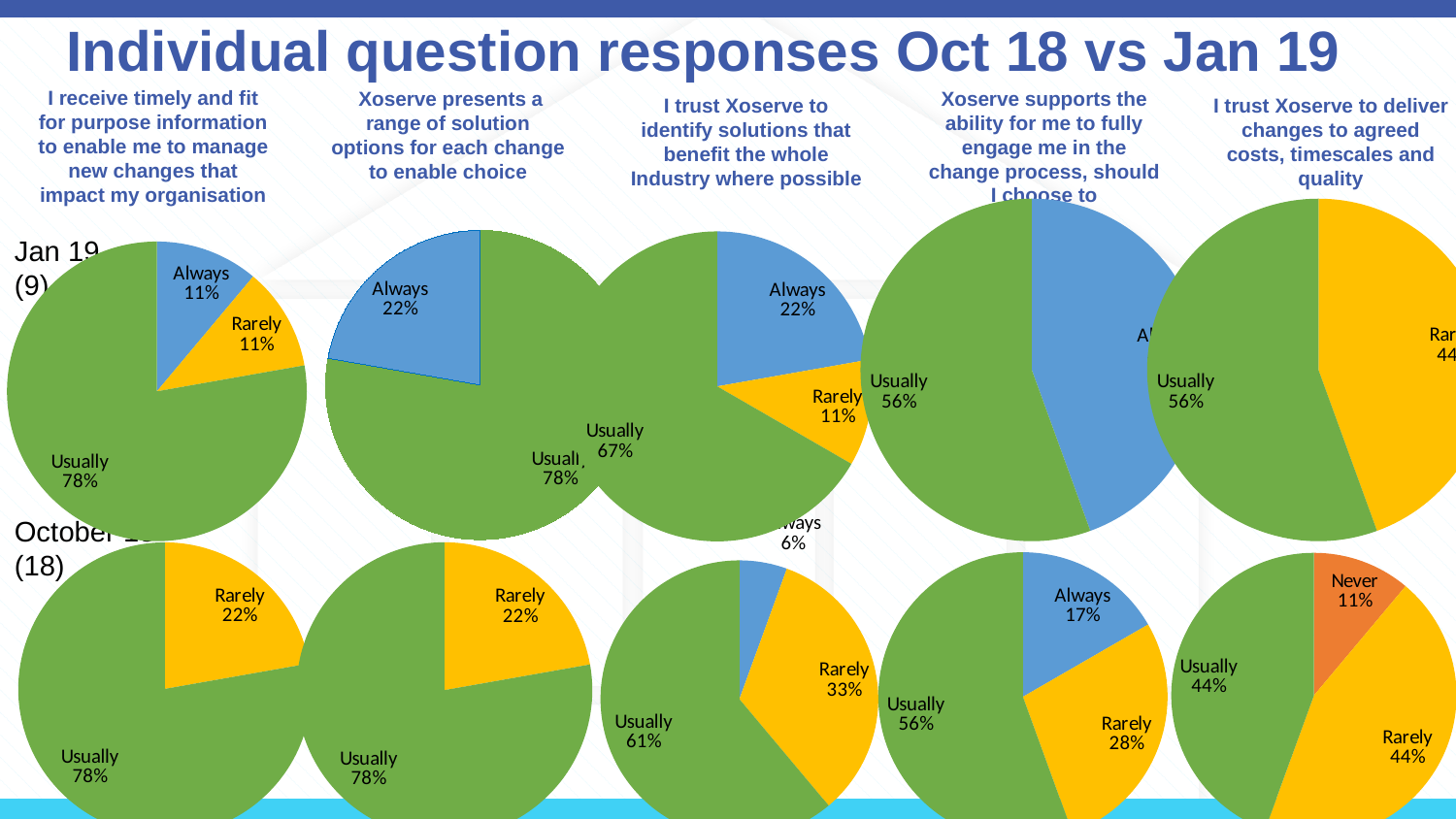
In the Jan 19 pie chart for 'I trust Xoserve to identify solutions that benefit the whole Industry where possible', what share is 'Usually'? 67% What kind of charts are shown on the slide? Pie charts In the October 18 pie chart for 'I trust Xoserve to identify solutions that benefit the whole Industry where possible', what share is 'Rarely'? 33% In the October 18 pie chart for 'I receive timely and fit for purpose information to enable me to manage new changes that impact my organisation', what share is 'Rarely'? 22% In the October 18 pie chart for 'Xoserve supports the ability for me to fully engage me in the change process, should I choose to', what is the difference between the 'Usually' and 'Rarely' shares? 28% In the October 18 pie chart for 'I trust Xoserve to deliver changes to agreed costs, timescales and quality', which is larger, 'Usually' or 'Never'? Usually In the October 18 pie chart for 'I trust Xoserve to identify solutions that benefit the whole Industry where possible', which slice is the largest? Usually